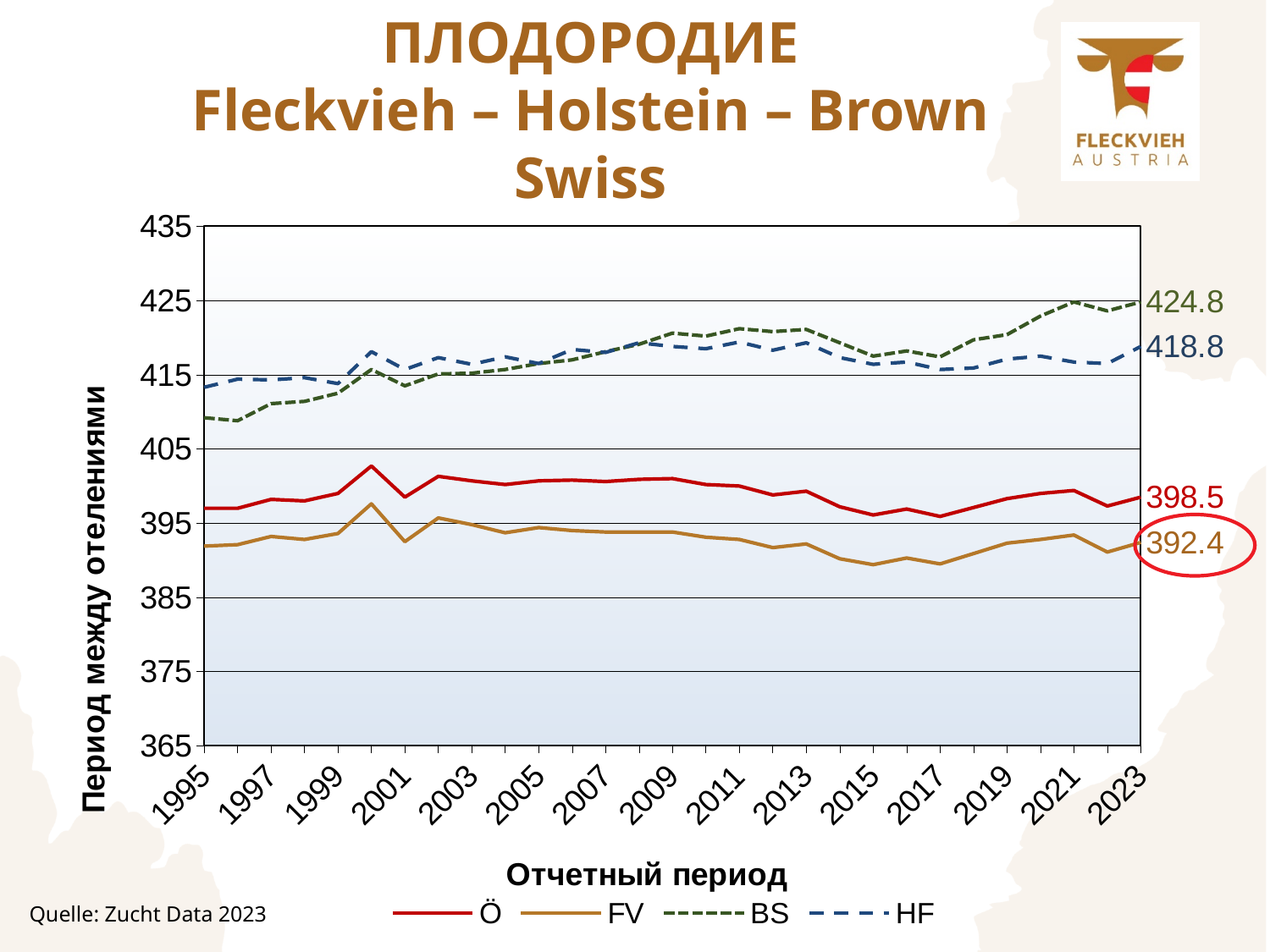
What type of chart is shown on the slide? line chart What is the value for the BS series in 2023? 424.8 Which series has the highest value in 2023? BS What is the value for the FV series in 2023? 392.4 What is the label of the y axis? Период между отелениями How many series does the legend list? 4 What is the value for the Ö series in 2023? 398.5 What is the value for the HF series in 2023? 418.8 What is the difference between the BS and FV values in 2023? 32.4 In 2023, which is larger, the HF value or the Ö value? HF Is the value for the FV series in 2015 greater or less than 395? less Which series has the lowest value in 2023? FV